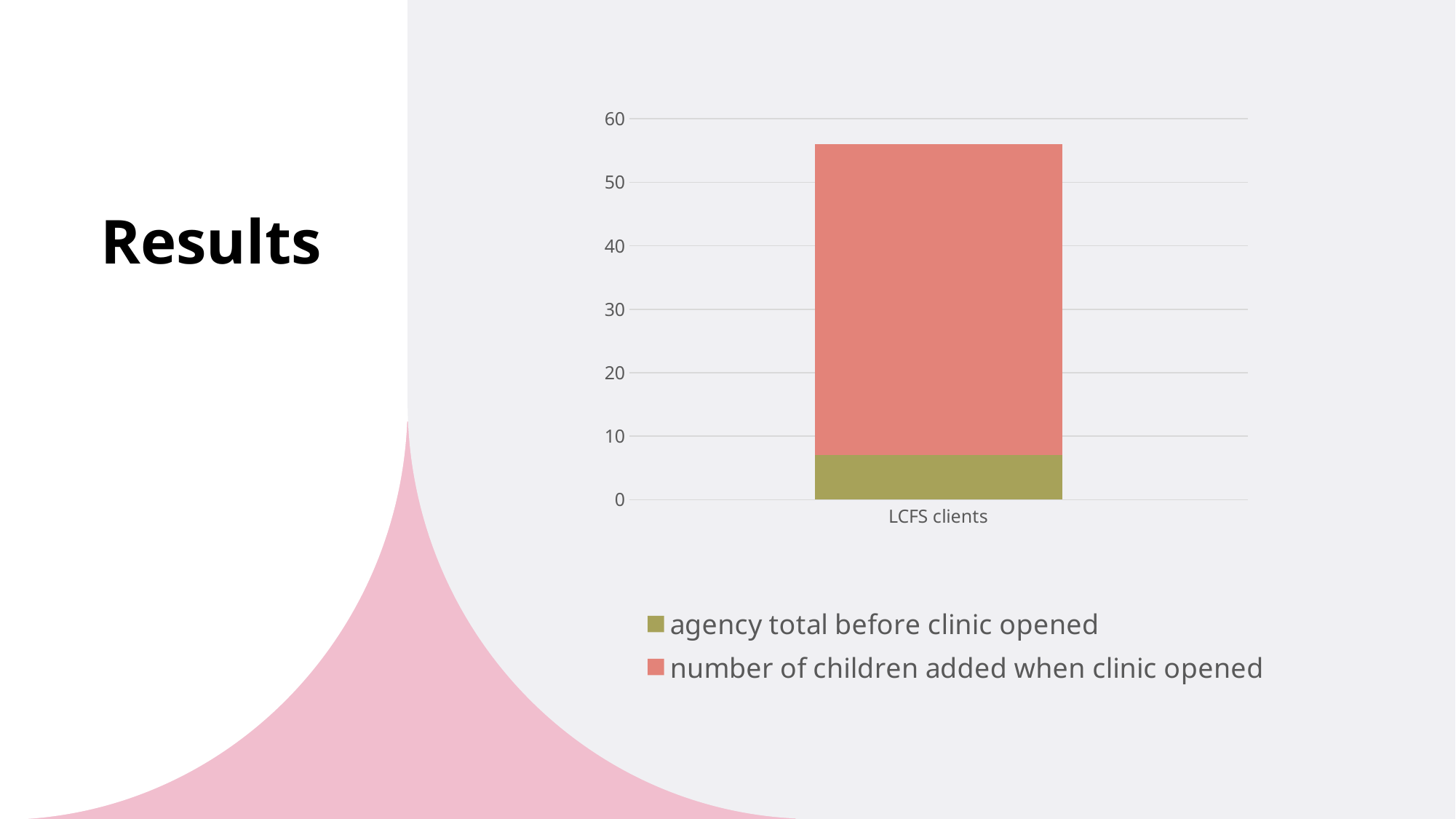
How many categories are shown on the x axis? 1 Is the value for 'agency total before clinic opened' greater or less than 10? less What is the highest tick value shown on the y axis? 60 How many series does the legend list? 2 Is the total height of the LCFS clients bar greater or less than 50? greater Is the total height of the LCFS clients bar greater or less than 60? less Which series is shown in green? agency total before clinic opened Which series contributes the smallest segment to the LCFS clients bar? agency total before clinic opened Which series has the larger value for LCFS clients: 'agency total before clinic opened' or 'number of children added when clinic opened'? number of children added when clinic opened What is the category label on the x axis? LCFS clients What kind of chart is shown on the slide? stacked bar chart